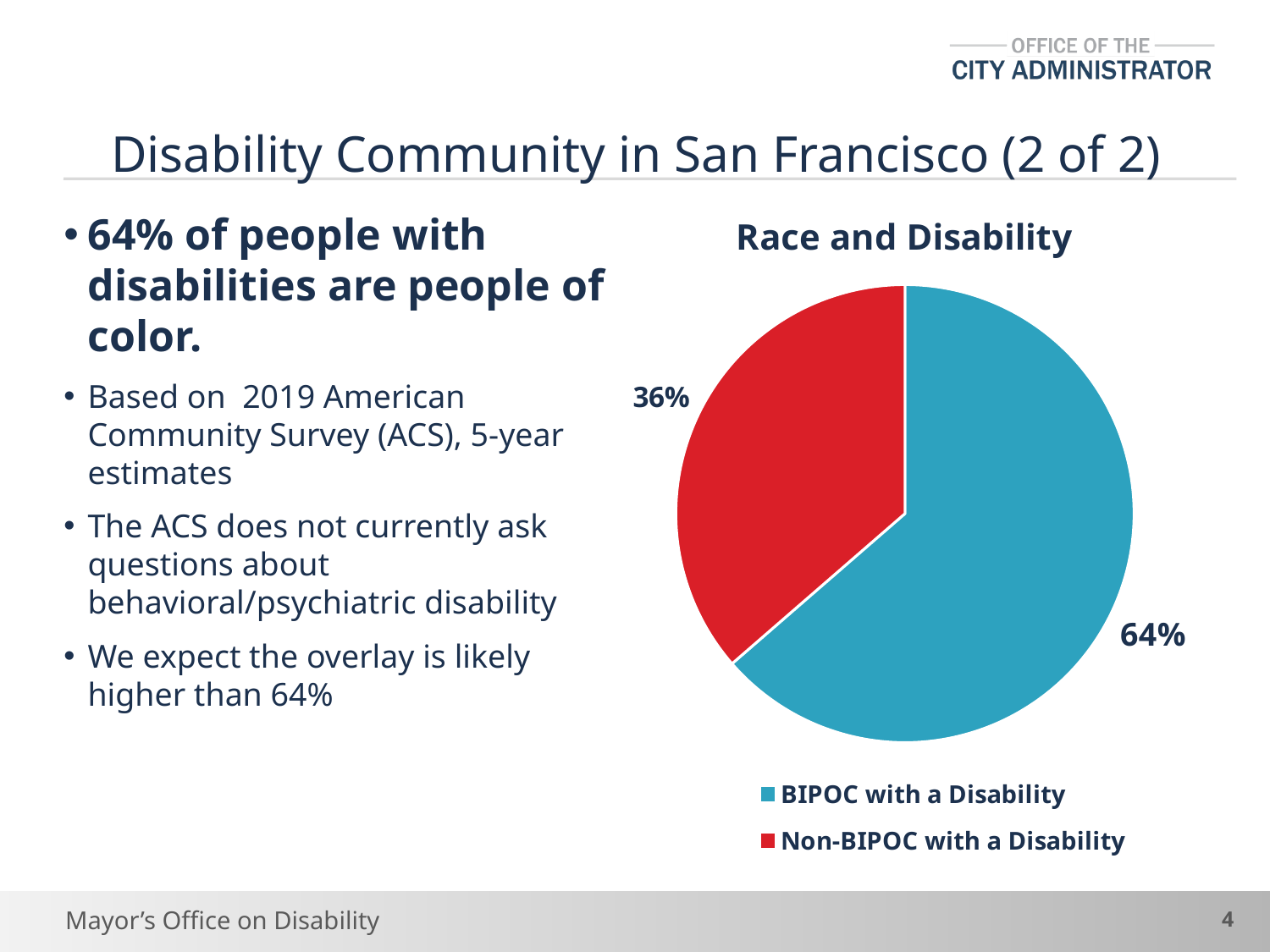
Which slice of the pie is the largest? BIPOC with a Disability Which is larger, the BIPOC with a Disability slice or the Non-BIPOC with a Disability slice? BIPOC with a Disability Which slice of the pie is the smallest? Non-BIPOC with a Disability What share of the pie is Non-BIPOC with a Disability? 36% What is the difference in percentage points between the BIPOC with a Disability slice and the Non-BIPOC with a Disability slice? 28 What colour is the Non-BIPOC with a Disability slice? Red What share of the pie is BIPOC with a Disability? 64% What is the title of the chart? Race and Disability How many slices does the pie chart have? 2 How many entries does the legend list? 2 What kind of chart is shown on the slide? Pie chart Is the share for BIPOC with a Disability greater or less than 50%? greater